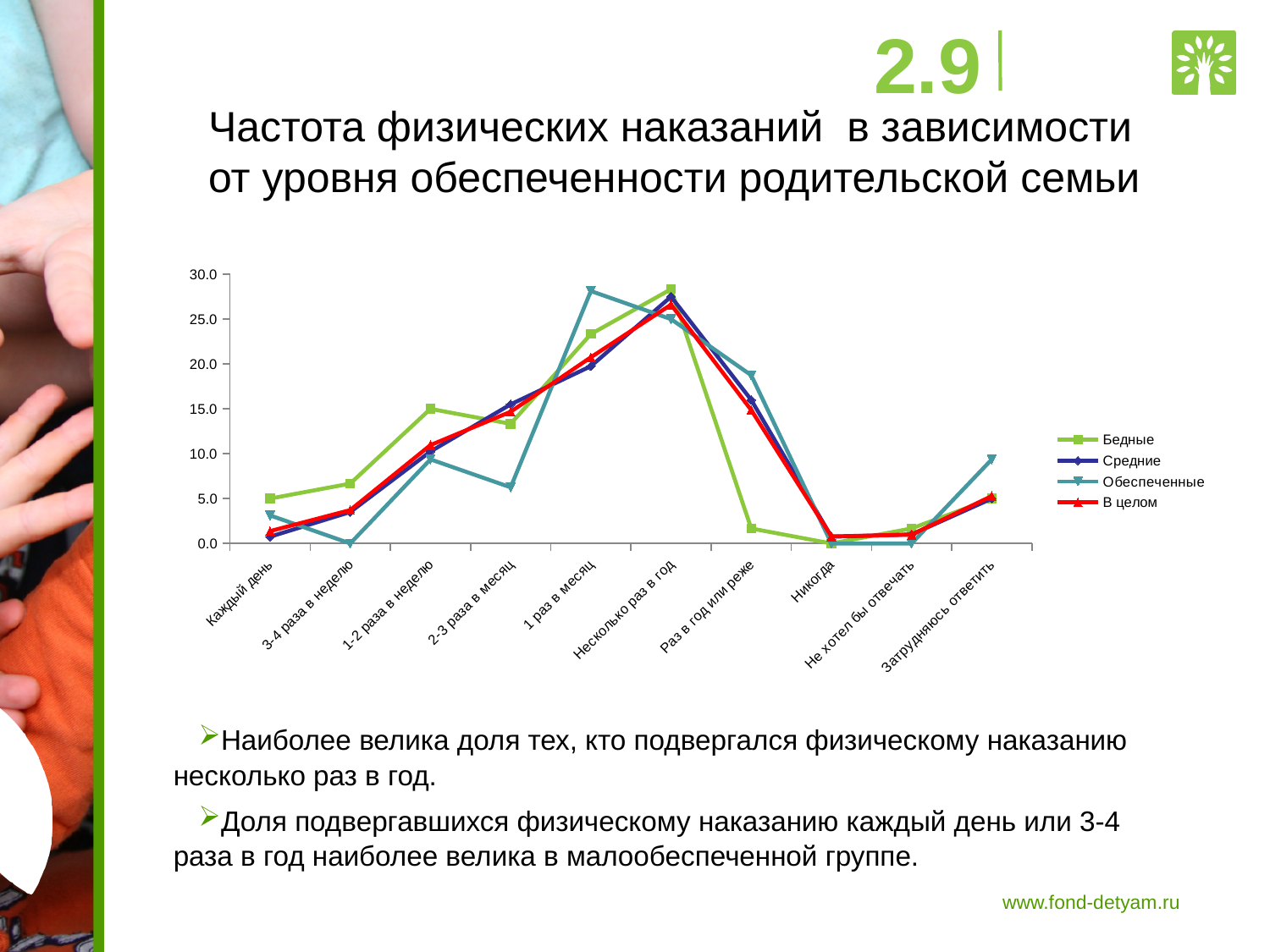
Is the value for Бедные at Раз в год или реже greater or less than 5.0? less Is the value for Обеспеченные at Затрудняюсь ответить greater or less than 5.0? greater At Раз в год или реже, which series has the larger value, Обеспеченные or Бедные? Обеспеченные Is the value for Обеспеченные at 1 раз в месяц greater or less than 25.0? greater What kind of chart is shown on the slide? line chart For the series Обеспеченные, which category has the highest value? 1 раз в месяц Which series is drawn in red in the legend? В целом At 2-3 раза в месяц, which series has the larger value, Средние or Обеспеченные? Средние How many categories are shown along the x axis? 10 For the series Бедные, which category has the highest value? Несколько раз в год How many series does the legend list? 4 For the series Бедные, which category has the lowest value? Никогда